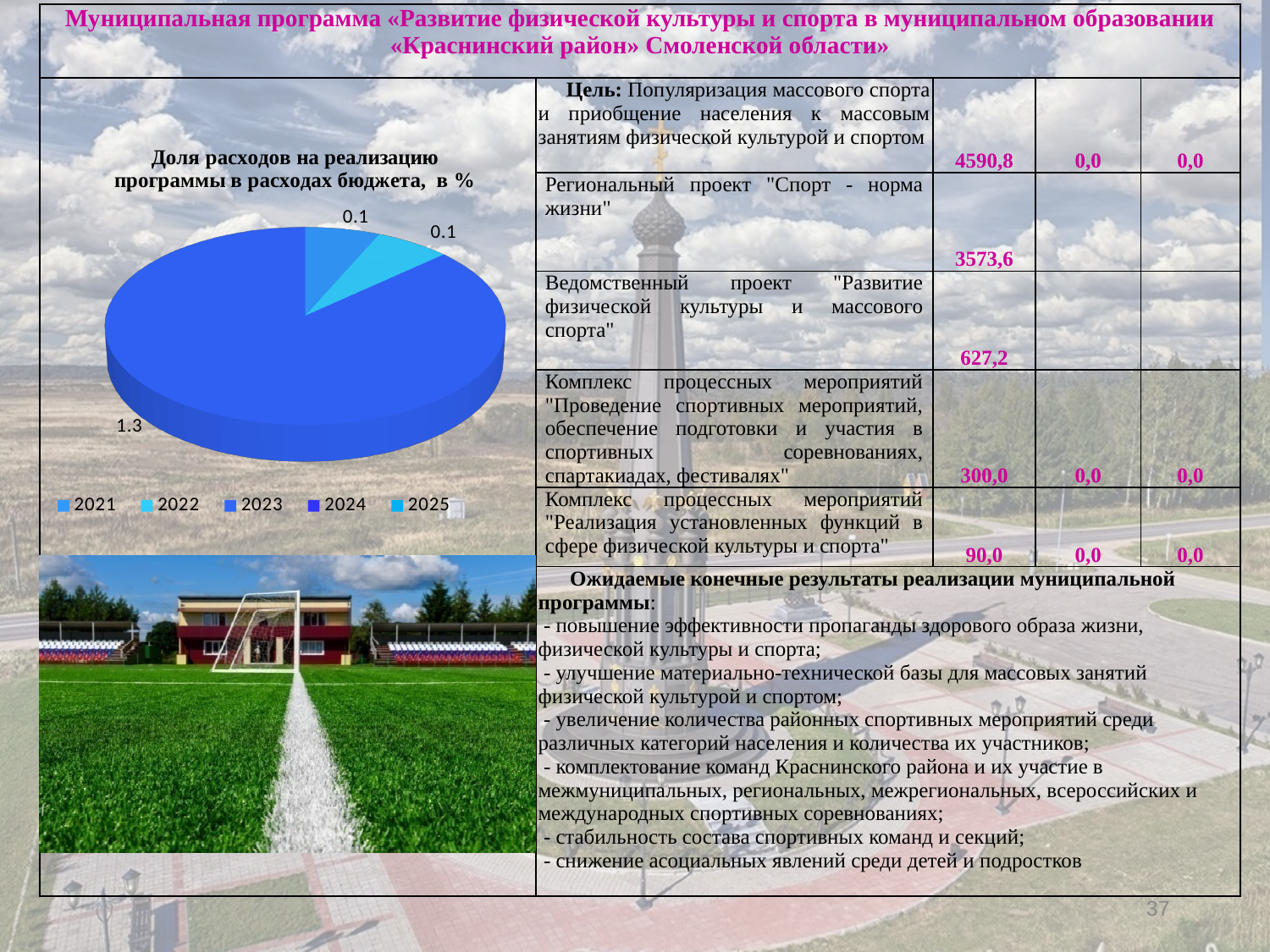
Which years are listed in the legend of the pie chart? 2021, 2022, 2023, 2024, 2025 In the pie chart, what is the value for 2023? 1.3 In the pie chart, what is the value for 2022? 0.1 In the pie chart, what is the value for 2021? 0.1 How many slices with data labels are shown in the pie chart? 3 What is the title of the pie chart? Доля расходов на реализацию программы в расходах бюджета, в % What kind of chart is shown on the left of the slide? pie chart In the pie chart, which is larger, the value for 2021 or the value for 2022? Neither; both are 0.1 Which year has the largest slice in the pie chart? 2023 In the pie chart, what is the difference between the value for 2021 and the value for 2023? 1.2 How many entries does the legend of the pie chart list? 5